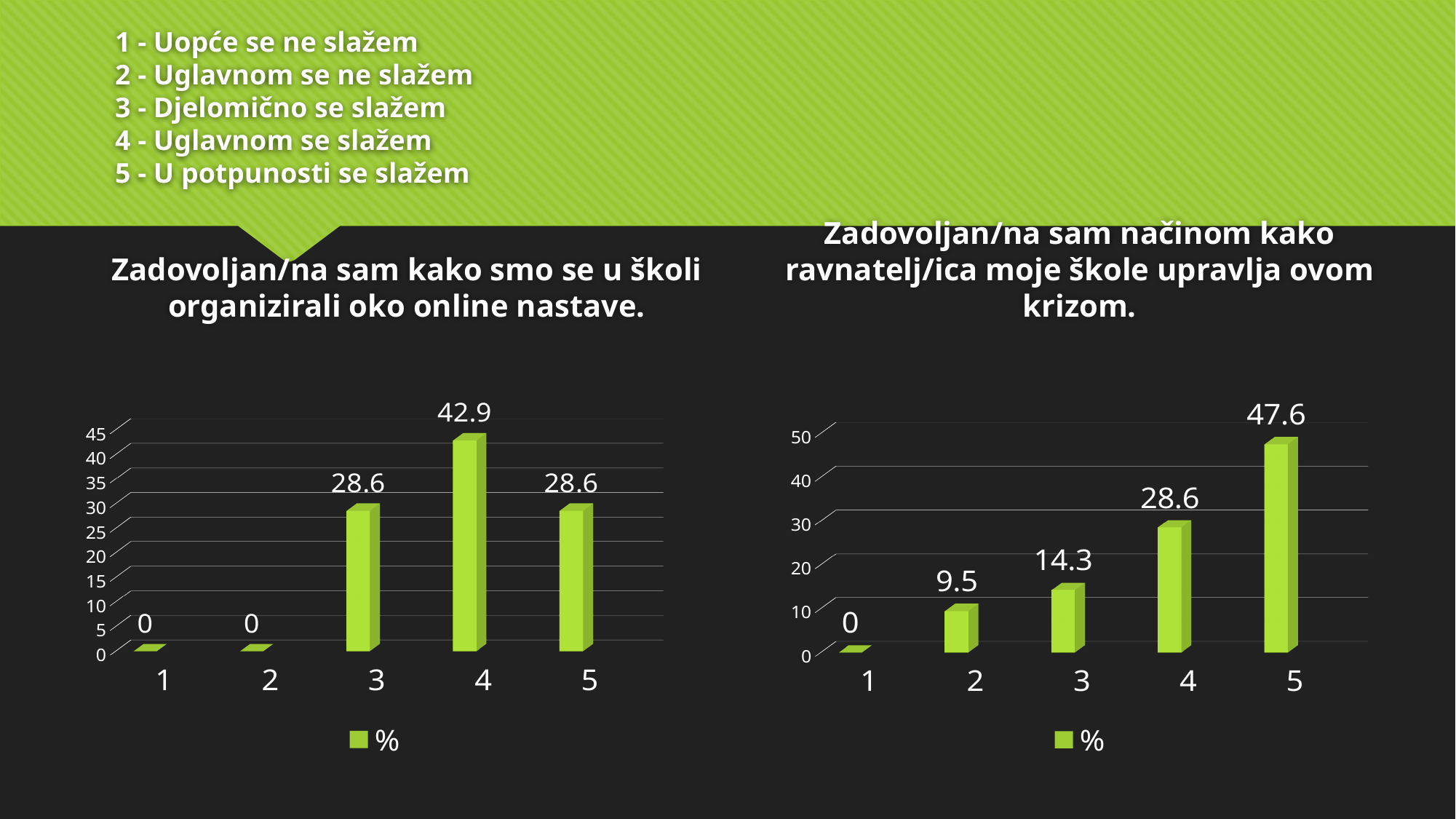
In the right chart (Zadovoljan/na sam načinom kako ravnatelj/ica moje škole upravlja ovom krizom), what is the value for category 2? 9.5 In the right chart (Zadovoljan/na sam načinom kako ravnatelj/ica moje škole upravlja ovom krizom), what is the difference between the values for category 4 and category 3? 14.3 In the left chart (Zadovoljan/na sam kako smo se u školi organizirali oko online nastave), what is the value for category 3? 28.6 In the right chart (Zadovoljan/na sam načinom kako ravnatelj/ica moje škole upravlja ovom krizom), do the values rise or fall from category 1 to category 5? rise In the left chart (Zadovoljan/na sam kako smo se u školi organizirali oko online nastave), how many categories are shown on the x axis? 5 In the right chart (Zadovoljan/na sam načinom kako ravnatelj/ica moje škole upravlja ovom krizom), which category has the lowest value? 1 In the right chart (Zadovoljan/na sam načinom kako ravnatelj/ica moje škole upravlja ovom krizom), what is the value for category 5? 47.6 In the left chart (Zadovoljan/na sam kako smo se u školi organizirali oko online nastave), which category has the highest value? 4 In the right chart (Zadovoljan/na sam načinom kako ravnatelj/ica moje škole upravlja ovom krizom), which is larger, the value for category 3 or category 4? 4 What kind of chart is the left chart (Zadovoljan/na sam kako smo se u školi organizirali oko online nastave)? bar chart In the left chart (Zadovoljan/na sam kako smo se u školi organizirali oko online nastave), what is the value for category 4? 42.9 In the left chart (Zadovoljan/na sam kako smo se u školi organizirali oko online nastave), what is the difference between the values for category 4 and category 5? 14.3